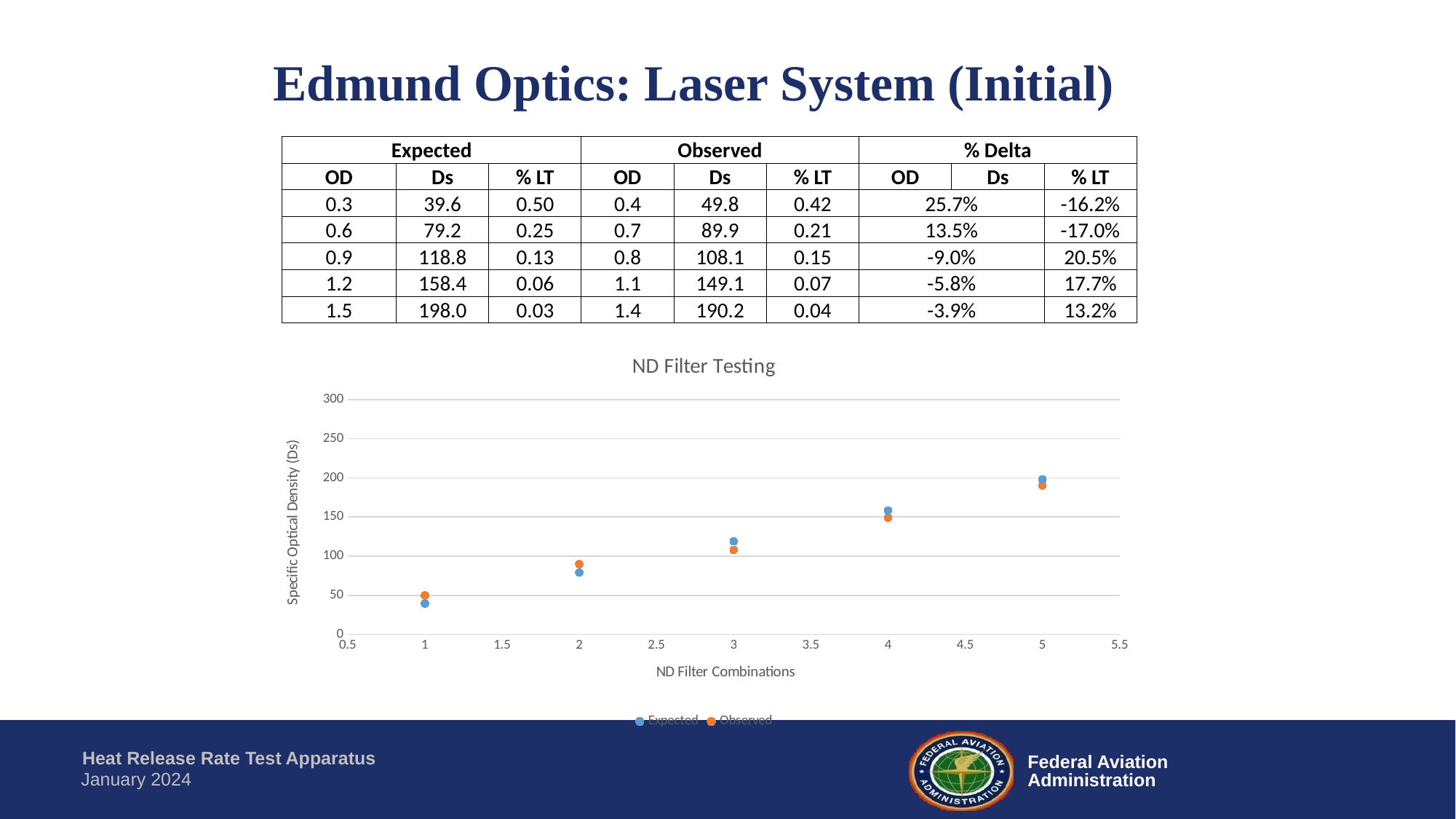
At ND Filter Combination 1, which series has the higher value, Expected or Observed? Observed Do the Expected values rise or fall as the ND Filter Combinations increase along the x axis? rise What is the label of the chart's y axis? Specific Optical Density (Ds) Is the Observed value at ND Filter Combination 2 greater or less than 100? less Is the Expected value at ND Filter Combination 4 greater or less than 150? greater Is the Expected value at ND Filter Combination 3 greater or less than 100? greater How many series does the chart's legend list? 2 How many data points are plotted for the Expected series? 5 What is the title of the chart? ND Filter Testing What kind of chart is shown on the slide? scatter chart At ND Filter Combination 5, which series has the higher value, Expected or Observed? Expected